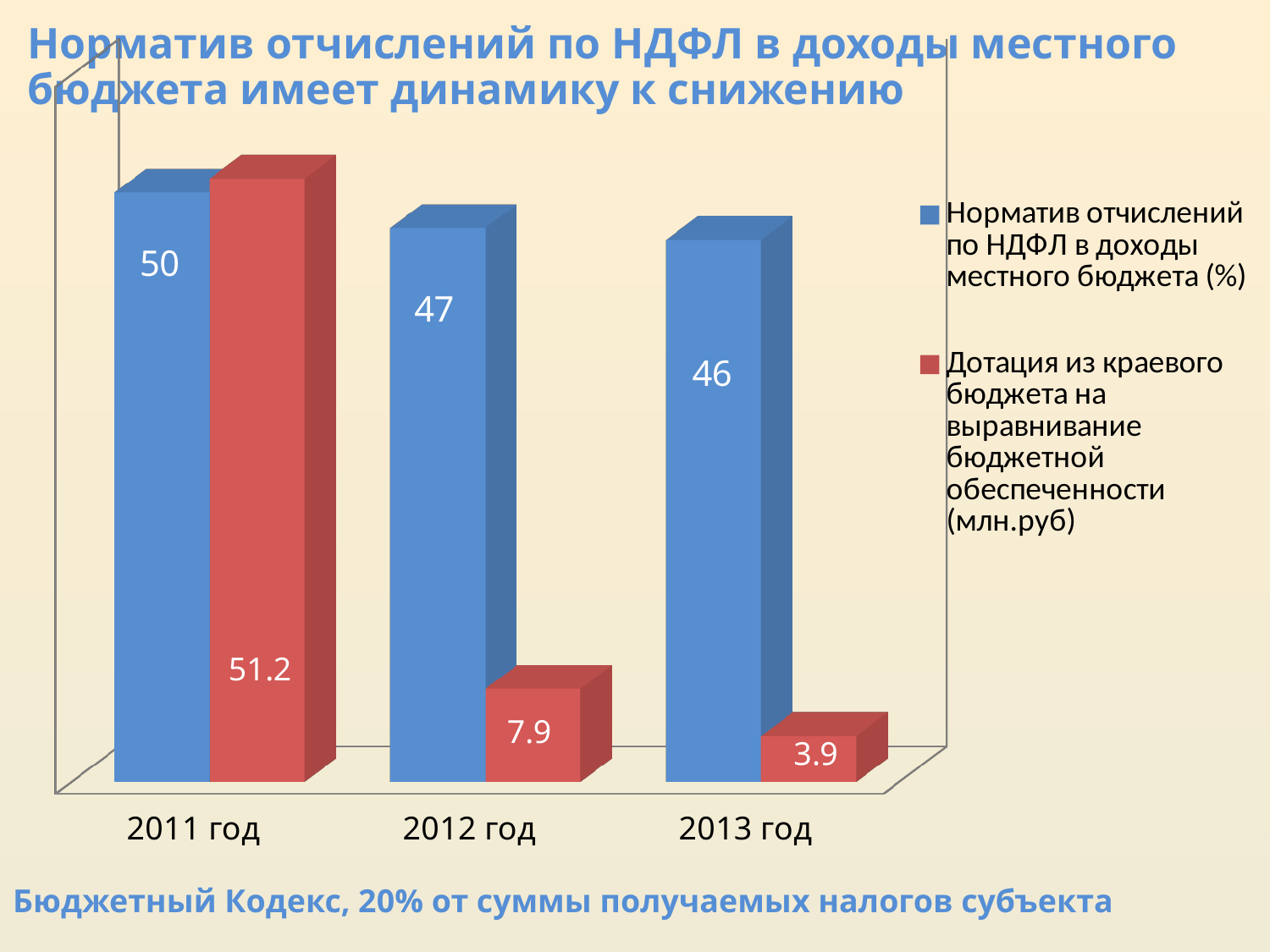
In which year is 'Норматив отчислений по НДФЛ в доходы местного бюджета (%)' the lowest? 2013 год What is the value of 'Норматив отчислений по НДФЛ в доходы местного бюджета (%)' for 2011 год? 50 What is the value of 'Дотация из краевого бюджета на выравнивание бюджетной обеспеченности (млн.руб)' for 2012 год? 7.9 How many years are shown on the x axis? 3 What is the difference between the 'Дотация из краевого бюджета' values for 2012 год and 2013 год? 4 In which year is 'Дотация из краевого бюджета на выравнивание бюджетной обеспеченности (млн.руб)' the highest? 2011 год Which is larger for 2012 год: 'Норматив отчислений по НДФЛ' or 'Дотация из краевого бюджета'? Норматив отчислений по НДФЛ What is the value of 'Дотация из краевого бюджета на выравнивание бюджетной обеспеченности (млн.руб)' for 2013 год? 3.9 What is the value of 'Норматив отчислений по НДФЛ в доходы местного бюджета (%)' for 2013 год? 46 How many series does the legend list? 2 What kind of chart is shown on the slide? Bar chart What is the difference between the 'Норматив отчислений по НДФЛ' values for 2011 год and 2013 год? 4